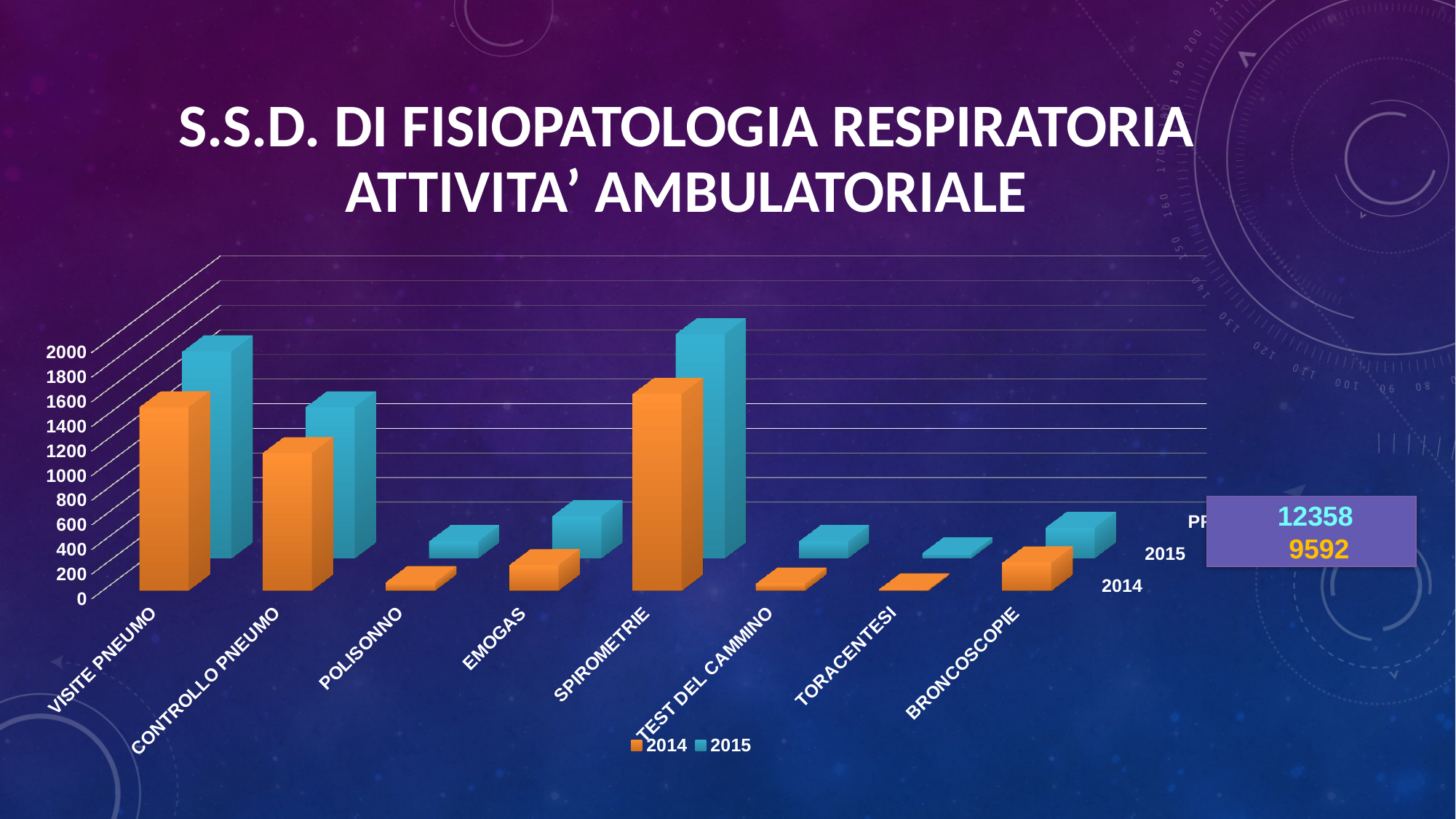
For VISITE PNEUMO, which is larger: the 2014 value or the 2015 value? 2015 Which is larger for 2014: VISITE PNEUMO or POLISONNO? VISITE PNEUMO Is the 2014 value for POLISONNO greater or less than 400? less Is the 2014 value for VISITE PNEUMO greater or less than 1000? greater For CONTROLLO PNEUMO, which is larger: the 2014 value or the 2015 value? 2015 What kind of chart is shown on the slide? bar chart Which series are listed in the legend? 2014 and 2015 How many categories are shown on the x axis? 8 Which category has the highest value for 2015? SPIROMETRIE What is the title of the slide containing the chart? S.S.D. DI FISIOPATOLOGIA RESPIRATORIA ATTIVITA' AMBULATORIALE How many series does the legend list? 2